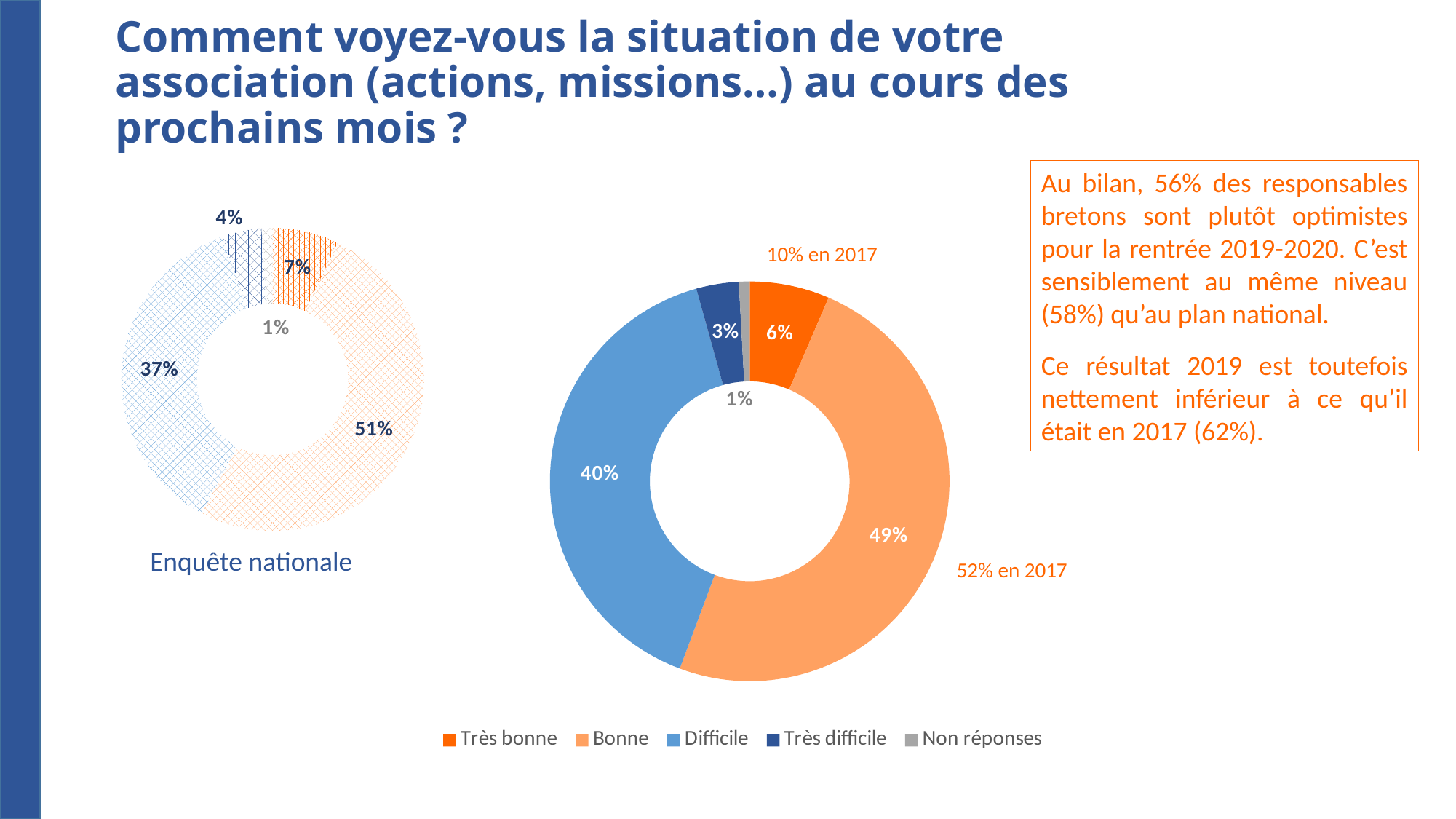
In the large donut chart on the right, what is the value for Difficile? 40% In the large donut chart on the right, what is the value for Bonne? 49% In the 'Enquête nationale' donut chart on the left, what is the value for Difficile (light blue)? 37% In the large donut chart on the right, which category has the largest share? Bonne In the 'Enquête nationale' donut chart on the left, what is the value for Bonne (light orange)? 51% In the large donut chart on the right, which category has the smallest share? Non réponses What kind of chart is the large chart on the right? Donut (pie) chart In the large donut chart on the right, what is the value for Très bonne? 6% In the large donut chart on the right, what is the value for Très difficile? 3% In the large donut chart on the right, which is larger: Très bonne or Très difficile? Très bonne In the large donut chart on the right, what is the difference between Bonne and Difficile? 9% How many categories does the legend list? 5